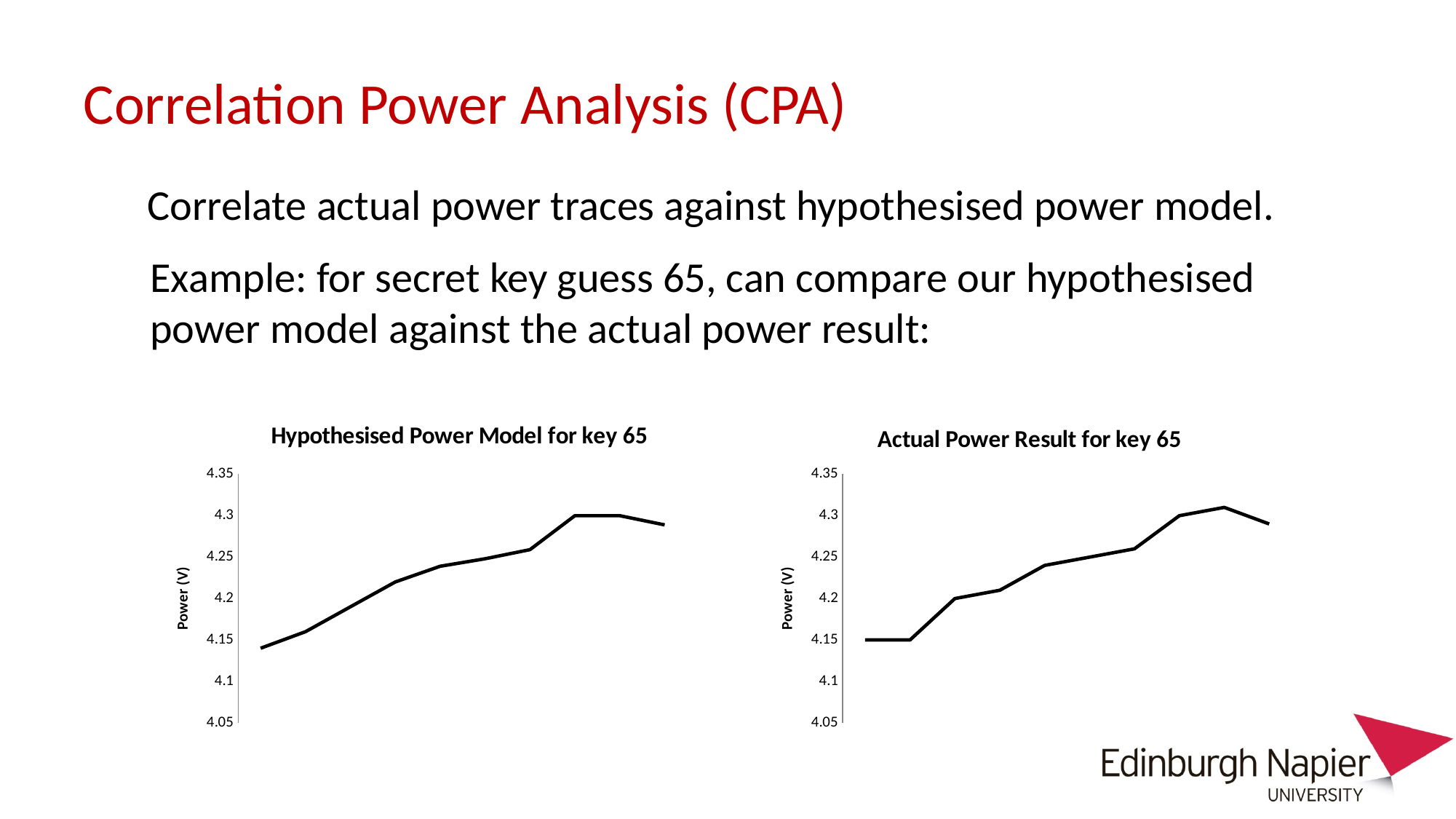
In the 'Actual Power Result for key 65' chart, do the values generally rise or fall along the x axis? rise In the 'Actual Power Result for key 65' chart, is the value of the first point greater or less than 4.2? less What kind of chart is the 'Actual Power Result for key 65' chart? line chart In the 'Hypothesised Power Model for key 65' chart, is the value of the first point greater or less than 4.2? less What is the y-axis label on the 'Actual Power Result for key 65' chart? Power (V) In the 'Hypothesised Power Model for key 65' chart, do the values generally rise or fall along the x axis? rise In the 'Actual Power Result for key 65' chart, is the value of the last point greater or less than 4.25? greater What kind of chart is the 'Hypothesised Power Model for key 65' chart? line chart What is the title of the chart on the left of the slide? Hypothesised Power Model for key 65